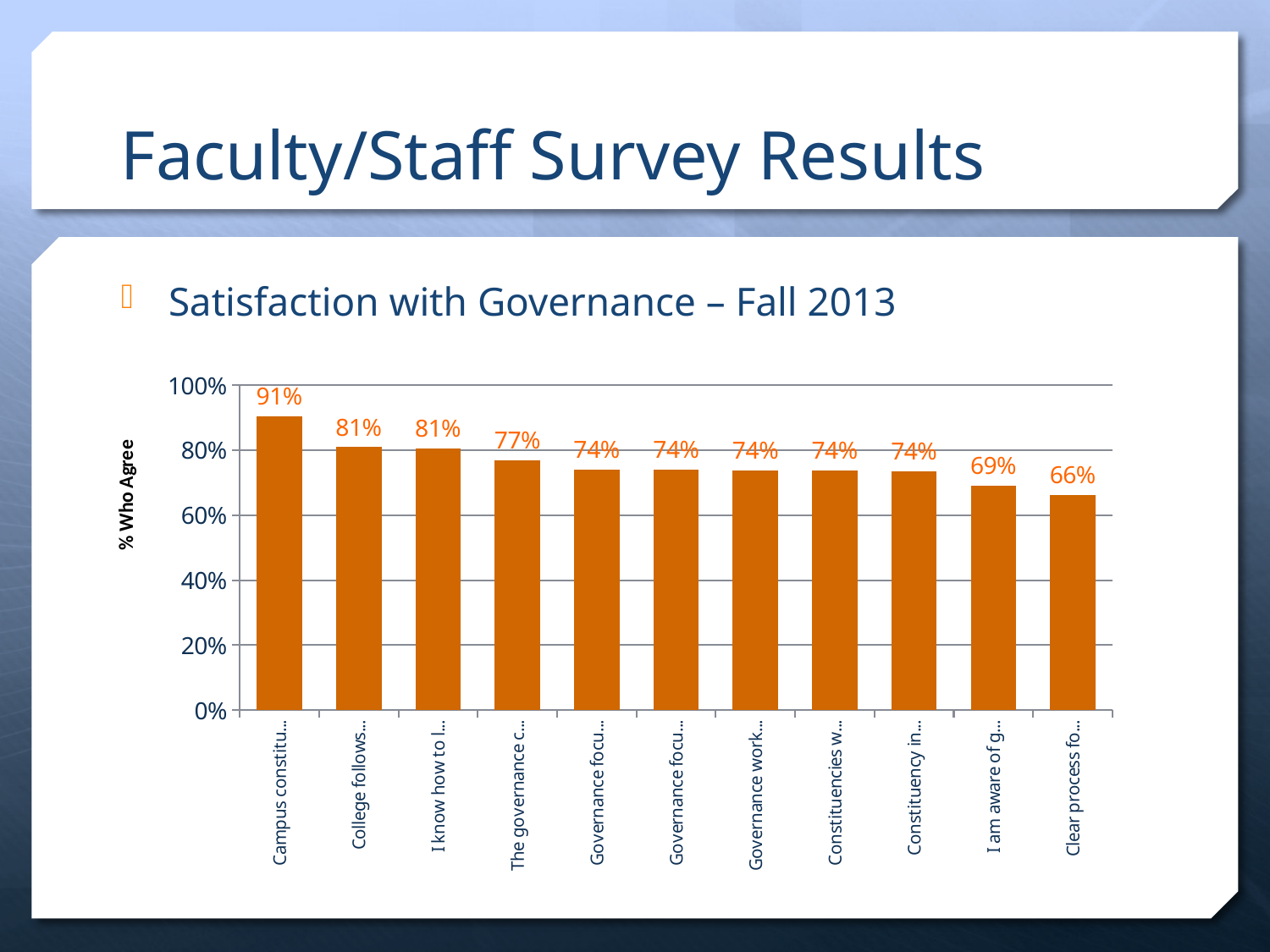
How many bars have a value of 74%? 5 What is the value of the rightmost bar, labelled "Clear process fo..."? 66% Which bar has the highest value in the chart? Campus constitu... (the leftmost bar) What is the difference between the highest bar (91%) and the lowest bar (66%)? 25% What is the value of the leftmost bar, labelled "Campus constitu..."? 91% What is the value of the bar labelled "I am aware of g..."? 69% Which is larger, the value for "College follows..." or the value for "Clear process fo..."? College follows... What kind of chart is shown on the slide? bar chart Which bar has the lowest value in the chart? Clear process fo... (the rightmost bar) Do the bar values rise or fall moving from left to right along the x axis? fall What is the title of the vertical axis? % Who Agree How many bars are plotted in the chart? 11